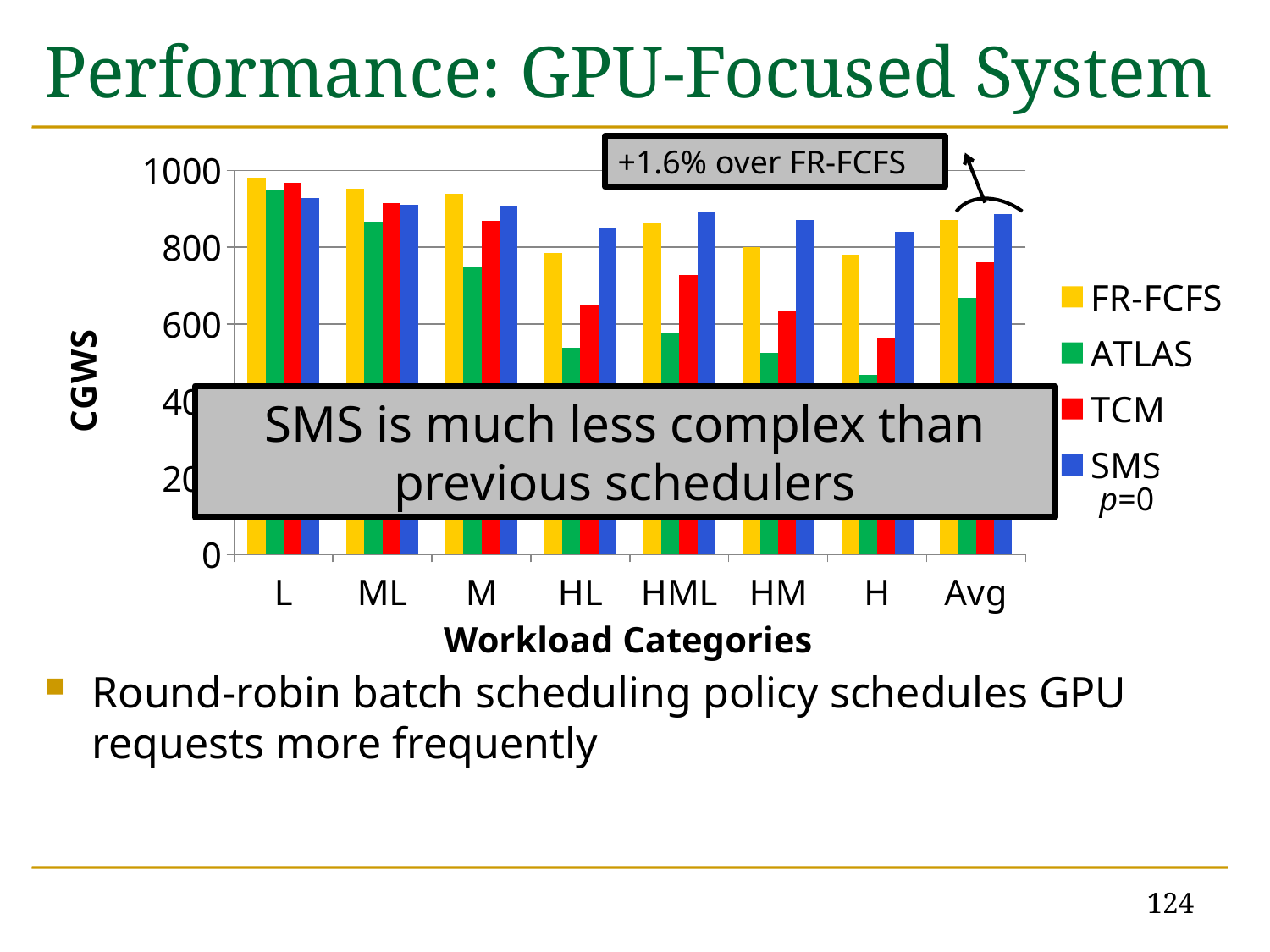
Is the FR-FCFS value for L greater or less than 800? greater How many workload categories are shown on the x axis? 8 For the HL category, which is larger, FR-FCFS or ATLAS? FR-FCFS For the HL category, which series has the lowest value? ATLAS Is the SMS value for HML greater or less than 800? greater Is the ATLAS value for M greater or less than 800? less For the H category, which is larger, SMS or ATLAS? SMS What kind of chart is shown on the slide? bar chart How many series does the legend list? 4 For the HM category, which series has the highest value? SMS What is the label on the y axis of the chart? CGWS